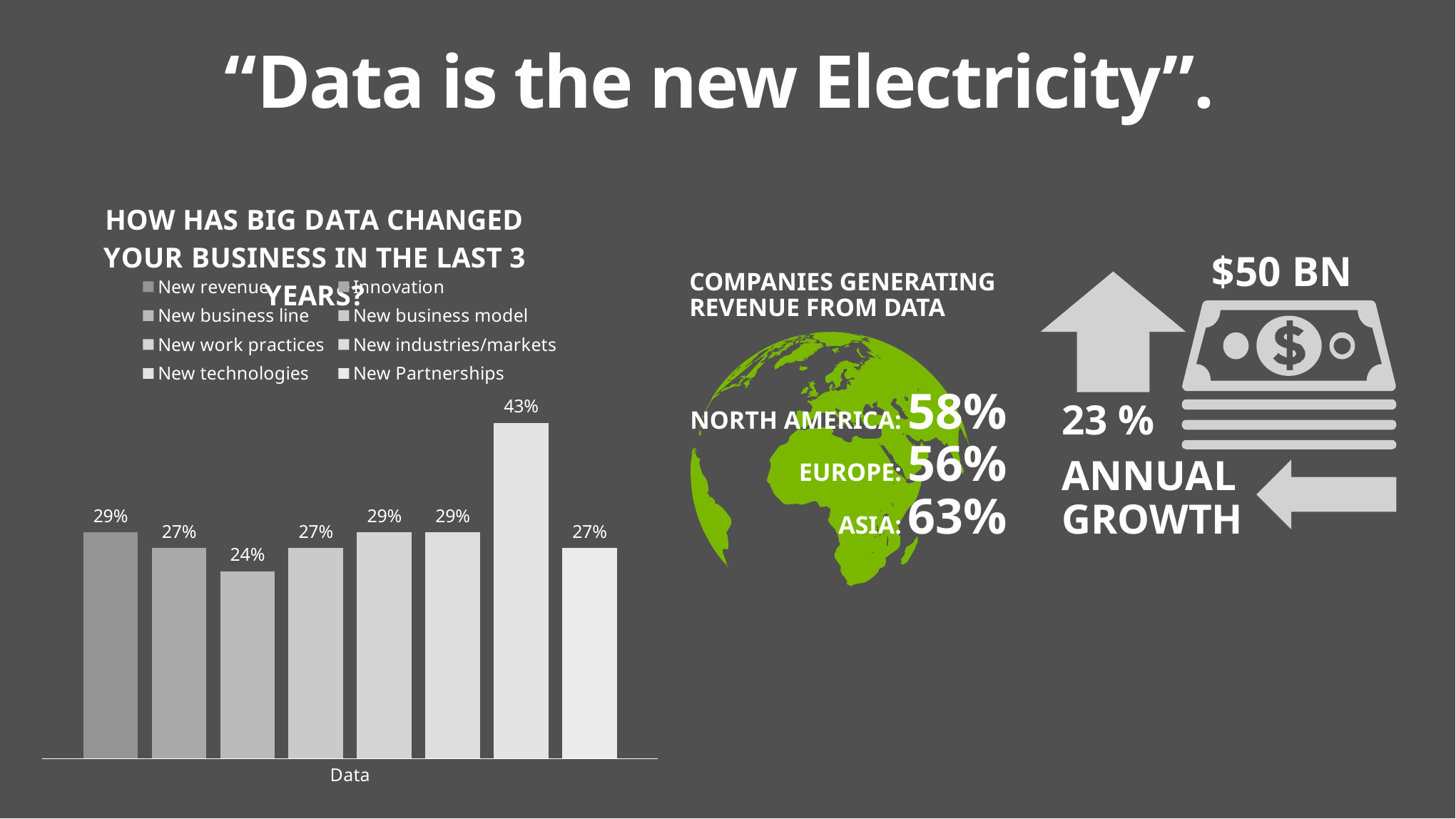
What is the lowest value shown on the bar chart? 24% What is the value of the third bar from the left in the bar chart? 24% How many bars are plotted in the bar chart? 8 How many series does the legend of the bar chart list? 8 What is the difference between the highest and lowest values on the bar chart? 19 percentage points What label appears on the category axis of the bar chart? Data Which is larger in the bar chart: the first bar or the second bar? the first bar What is the title of the bar chart on the left? HOW HAS BIG DATA CHANGED YOUR BUSINESS IN THE LAST 3 YEARS? What is the value of the first (leftmost) bar in the bar chart? 29% What is the highest value shown on the bar chart? 43% How many bars in the bar chart are labelled 27%? 3 What kind of chart is shown on the left of the slide? bar chart